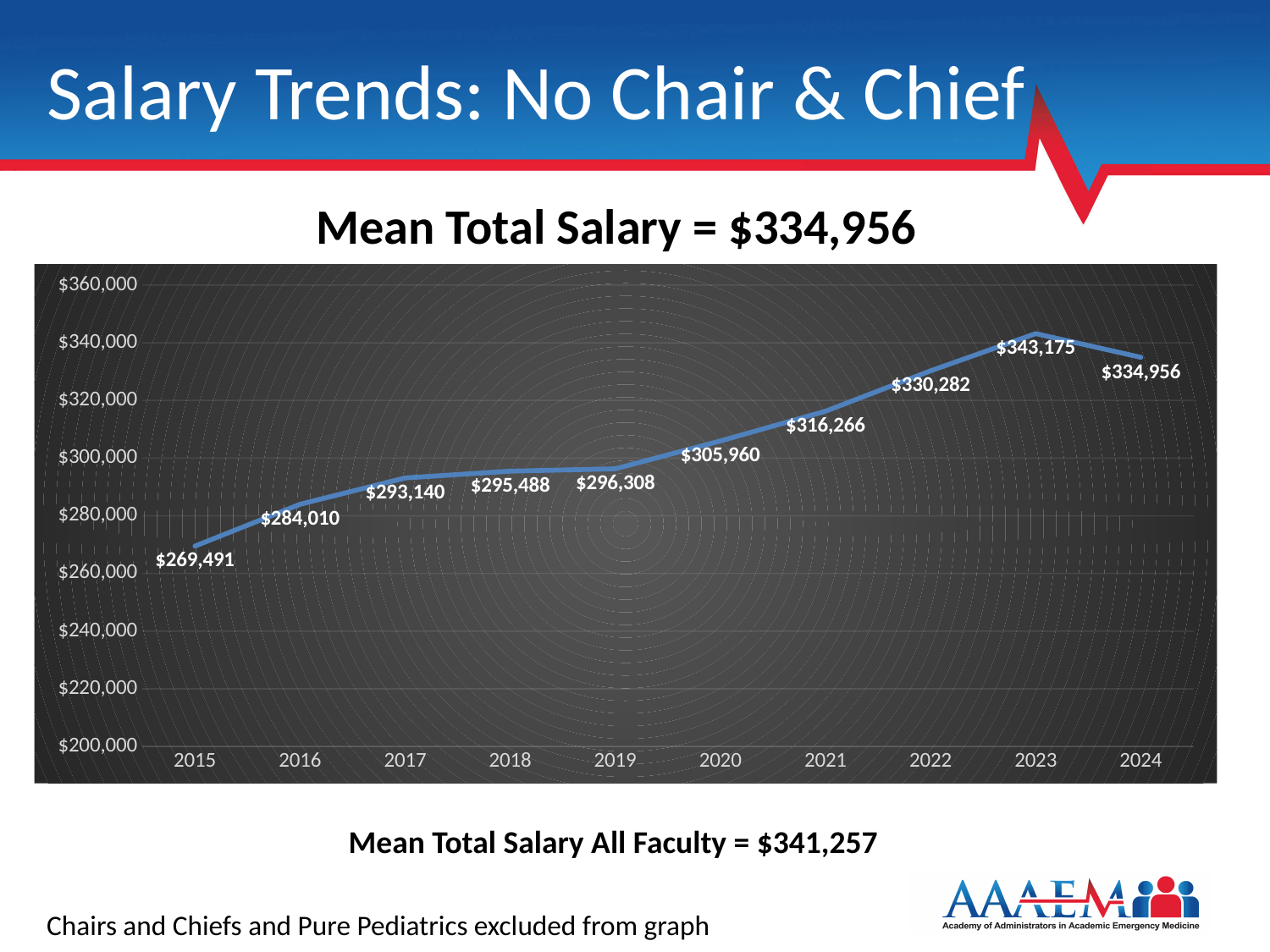
How many years are plotted on the x axis? 10 How much higher is the 2024 value than the 2015 value? $65,465 What kind of chart is shown on the slide? line chart Which year has the lowest mean total salary on the chart? 2015 By how much did the mean total salary fall from 2023 to 2024? $8,219 Which is larger, the value for 2018 or the value for 2021? 2021 Is the value for 2022 greater or less than $320,000? greater What is the mean total salary shown for 2015? $269,491 What is the overall trend of the mean total salary from 2015 to 2023? rising Which year has the highest mean total salary on the chart? 2023 What is the mean total salary shown for 2020? $305,960 What is the mean total salary shown for 2024? $334,956